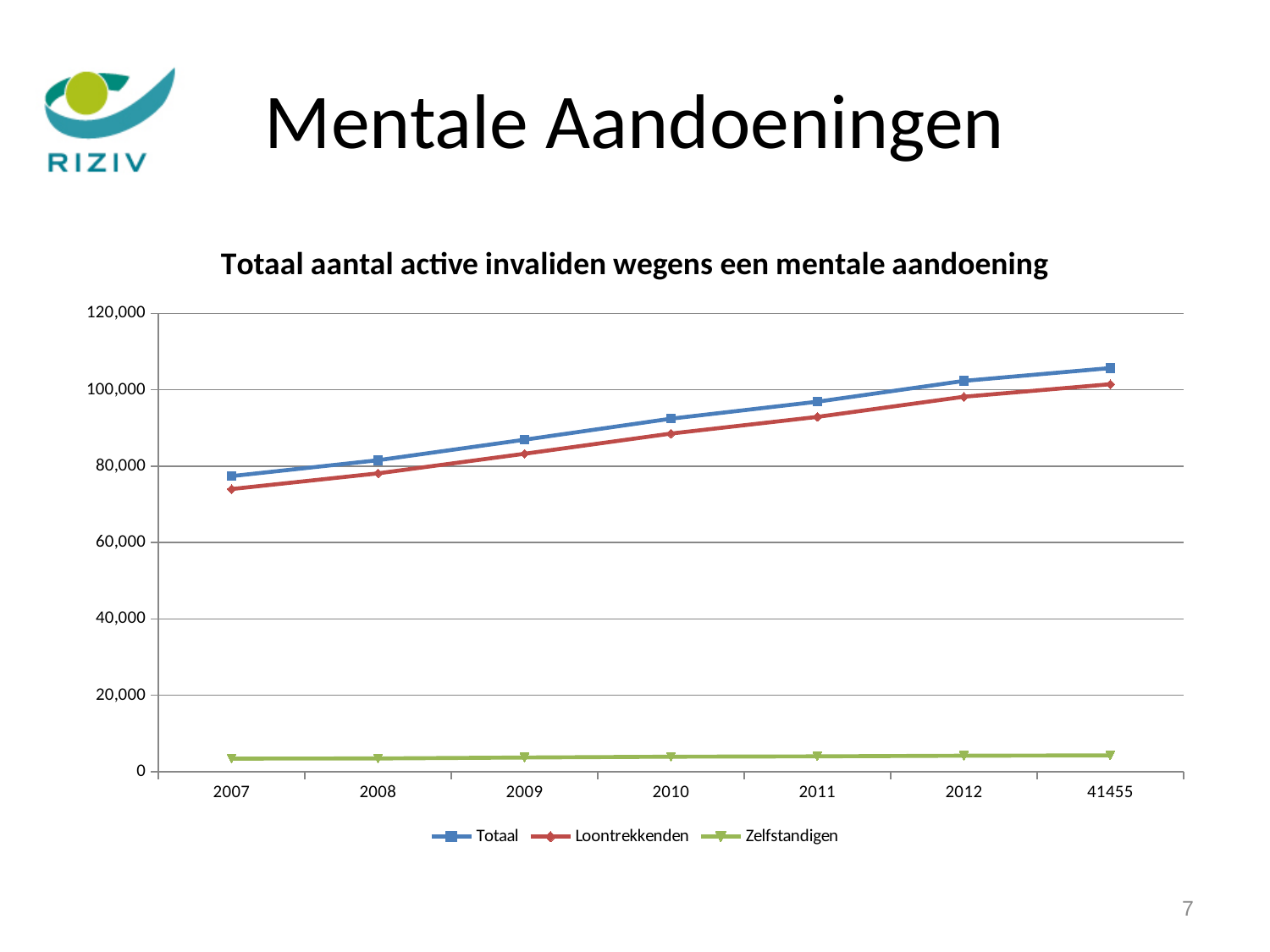
In which year is the Totaal series lowest? 2007 Is the value for Totaal in 2007 greater or less than 80,000? less Is the value for Loontrekkenden in 2007 greater or less than 80,000? less What kind of chart is shown on the slide? line chart Is the value for Totaal in 2010 greater or less than 80,000? greater How many points are plotted along the x axis for each series? 7 Does the Totaal series rise or fall from 2007 to the last point? rise At which x-axis label is the Totaal series highest? 41455 In 2011, which is larger: Totaal or Zelfstandigen? Totaal How many series does the legend list? 3 What is the title of the chart? Totaal aantal active invaliden wegens een mentale aandoening